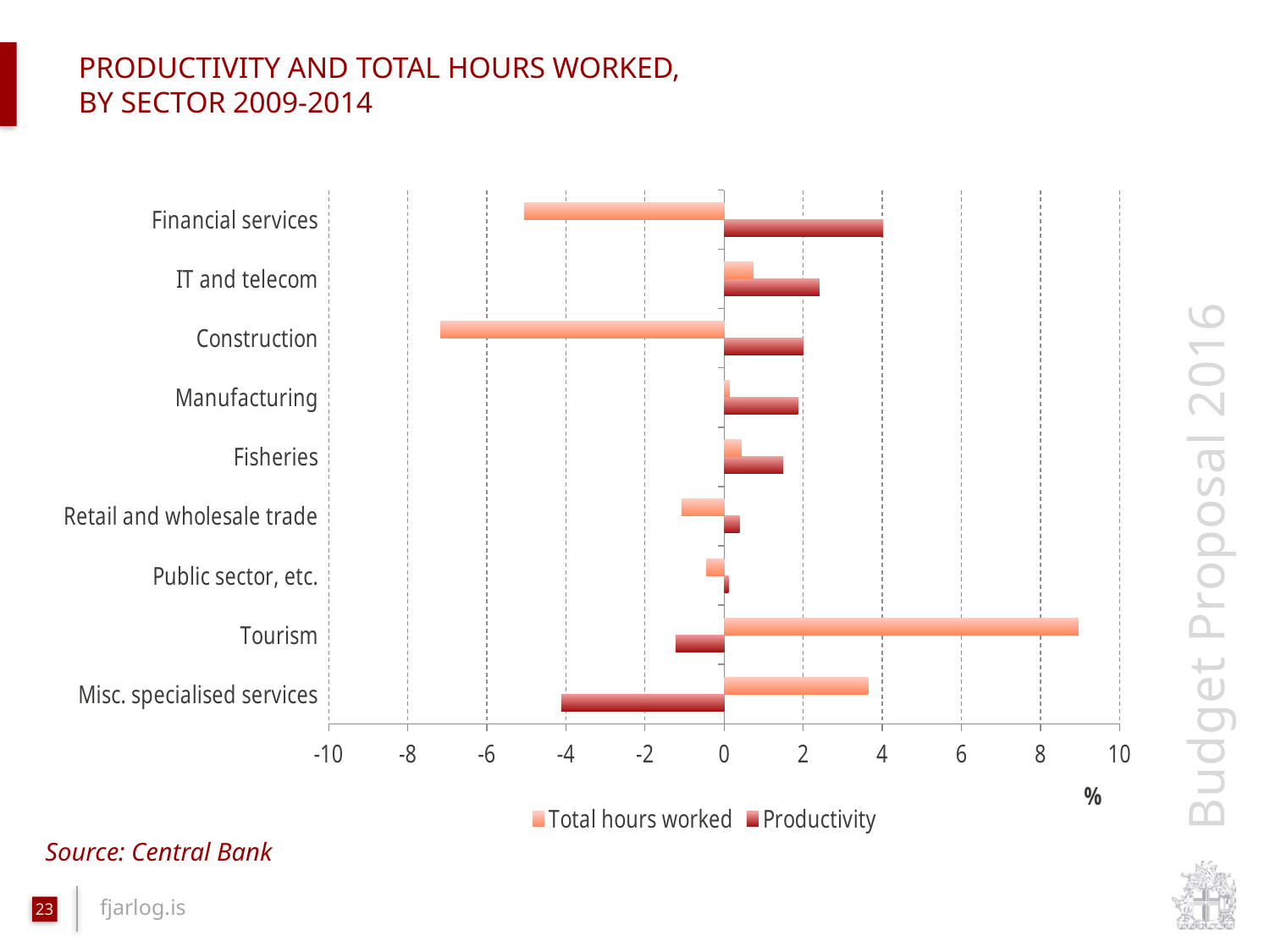
Which has the larger Productivity value, Financial services or IT and telecom? Financial services Which sector has the lowest value for Total hours worked? Construction Which sector has the highest Productivity value? Financial services How many series does the legend list? 2 Is the Total hours worked value for Construction greater or less than -6? less What are the two series named in the legend? Total hours worked and Productivity Is the Productivity value for Misc. specialised services greater or less than -2? less Is the Total hours worked value for Tourism greater or less than 8? greater Which sector has the highest value for Total hours worked? Tourism Which sector has the lowest Productivity value? Misc. specialised services How many sectors are plotted on the chart? 9 What kind of chart is shown on the slide? Bar chart